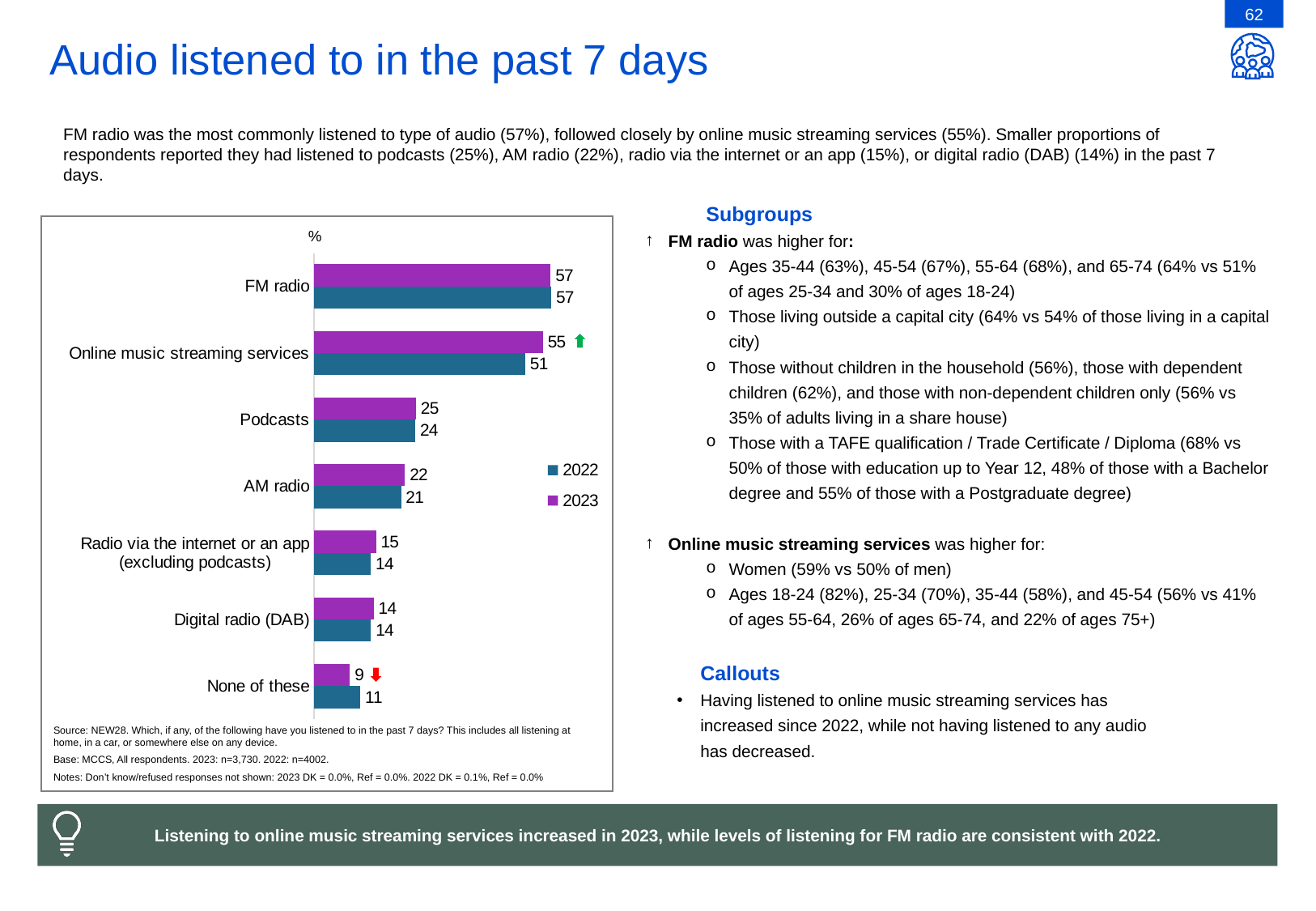
What kind of chart is shown on the slide? Bar chart What was the value for FM radio in 2023? 57 Which category had the highest value in 2023? FM radio Which category had the lowest value in 2022? None of these How many series does the legend list? 2 What was the value for Online music streaming services in 2022? 51 What was the value for Podcasts in 2022? 24 How many categories are shown in the chart? 7 What was the value for None of these in 2023? 9 What is the difference between the 2023 and 2022 values for Online music streaming services? 4 Which was larger for None of these, the 2022 value or the 2023 value? 2022 Which colour represents 2023 in the chart? Purple